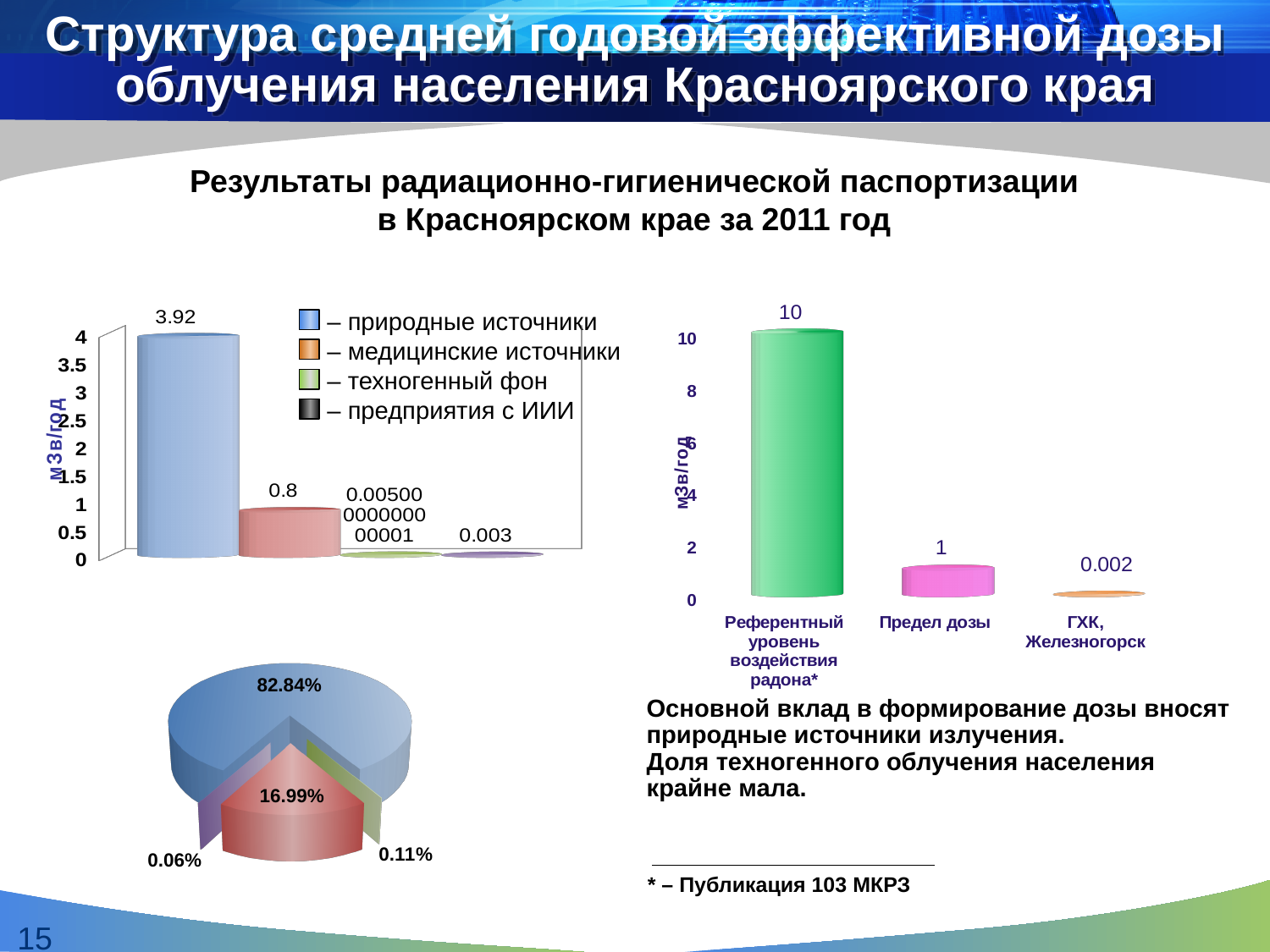
In the top-left bar chart, what is the unit shown on the vertical axis? мЗв/год How many categories are shown in the top-right bar chart? 3 In the top-right bar chart, what is the value for 'Референтный уровень воздействия радона*'? 10 In the top-left bar chart, what is the difference between the first bar (3.92) and the second bar (0.8)? 3.12 In the top-right bar chart, what is the difference between 'Референтный уровень воздействия радона*' and 'Предел дозы'? 9 In the top-left bar chart, what is the value of the second bar? 0.8 In the top-left bar chart, what is the value of the tallest bar (the first bar)? 3.92 In the top-right bar chart, what is the value for 'ГХК, Железногорск'? 0.002 In the pie chart at the bottom left, what is the share of the largest slice? 82.84% In the top-right bar chart, which category has the lowest value? ГХК, Железногорск How many entries does the legend of the top-left bar chart list? 4 In the top-right bar chart, what is the value for 'Предел дозы'? 1